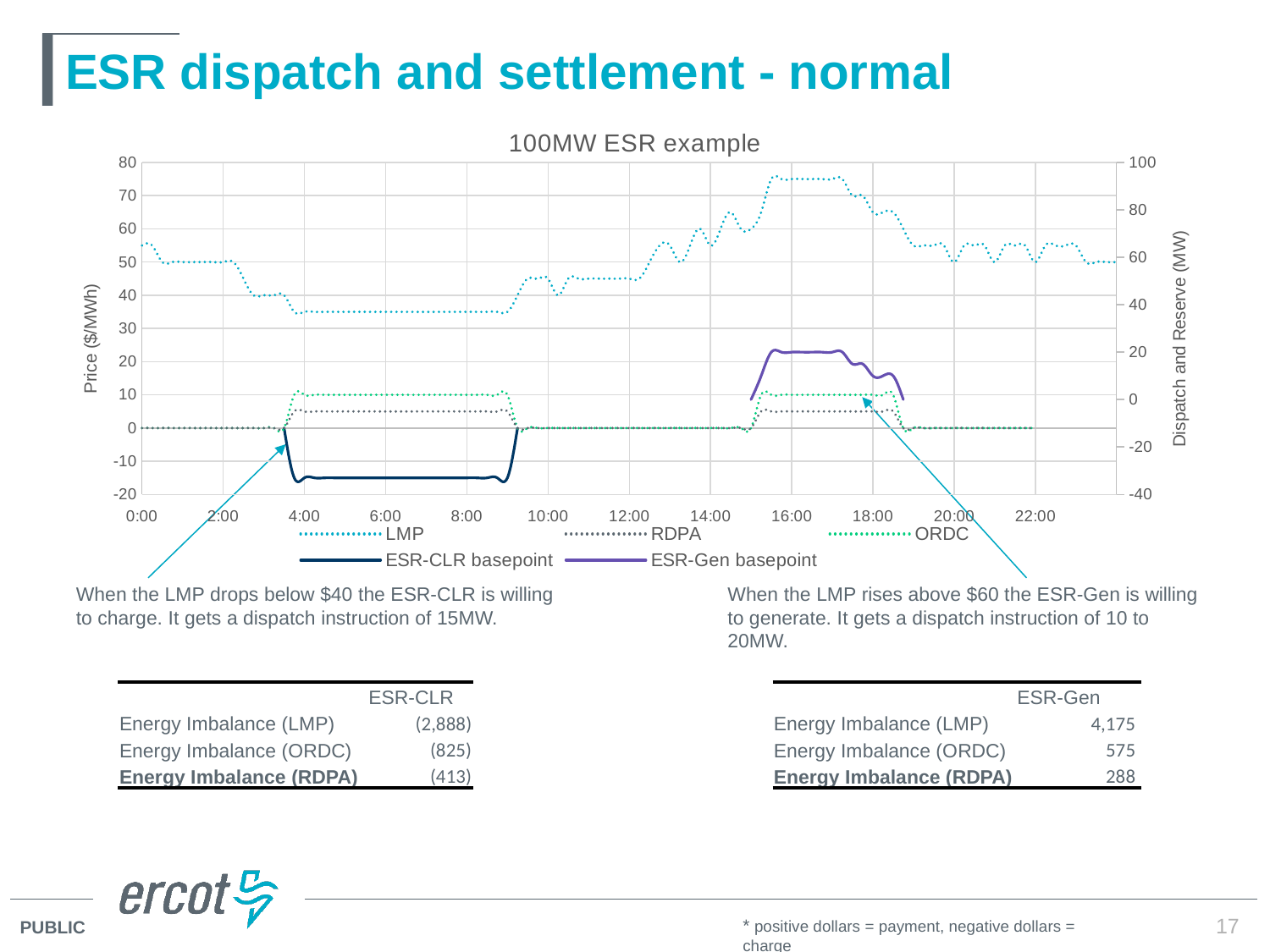
What is the label of the left vertical axis of the chart? Price ($/MWh) How many series does the chart legend list? 5 Does the LMP line rise or fall between 14:00 and 16:00? rise Is the LMP value at 2:00 greater or less than 40? greater Does the LMP line rise or fall between 18:00 and 20:00? fall Is the ESR-Gen basepoint value at 16:00 greater or less than 0 on the right axis? greater Is the LMP value at 16:00 greater or less than 70? greater How many time labels are shown on the x axis of the chart? 12 What is the title of the chart? 100MW ESR example What kind of chart is shown on the slide? line chart